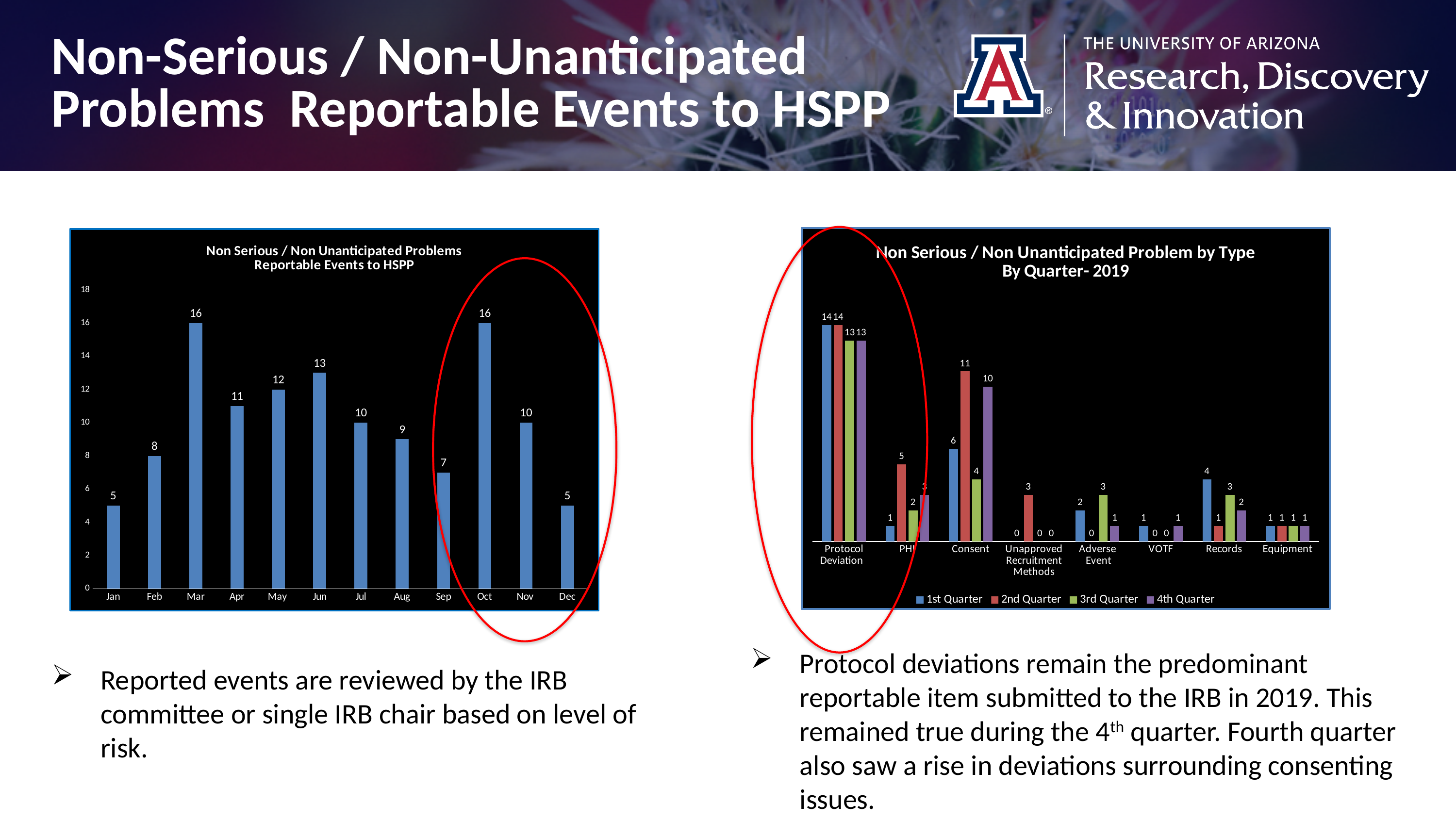
In the right chart (Non Serious / Non Unanticipated Problem by Type By Quarter- 2019), which type has the highest 4th Quarter value? Protocol Deviation In the left chart (Non Serious / Non Unanticipated Problems Reportable Events to HSPP), what is the value for Jun? 13 In the right chart (Non Serious / Non Unanticipated Problem by Type By Quarter- 2019), how many series does the legend list? 4 What kind of chart is the left chart (Non Serious / Non Unanticipated Problems Reportable Events to HSPP)? Bar chart In the right chart (Non Serious / Non Unanticipated Problem by Type By Quarter- 2019), what is the difference between the 1st Quarter and 3rd Quarter values for Protocol Deviation? 1 In the right chart (Non Serious / Non Unanticipated Problem by Type By Quarter- 2019), which colour represents the 2nd Quarter series? Red In the left chart (Non Serious / Non Unanticipated Problems Reportable Events to HSPP), how many months are shown on the x axis? 12 In the right chart (Non Serious / Non Unanticipated Problem by Type By Quarter- 2019), what is the 1st Quarter value for Records? 4 In the left chart (Non Serious / Non Unanticipated Problems Reportable Events to HSPP), what is the value for Mar? 16 In the left chart (Non Serious / Non Unanticipated Problems Reportable Events to HSPP), what is the difference between the values for Oct and Nov? 6 In the right chart (Non Serious / Non Unanticipated Problem by Type By Quarter- 2019), what is the 2nd Quarter value for Consent? 11 In the left chart (Non Serious / Non Unanticipated Problems Reportable Events to HSPP), which is larger, the value for Feb or the value for Sep? Feb